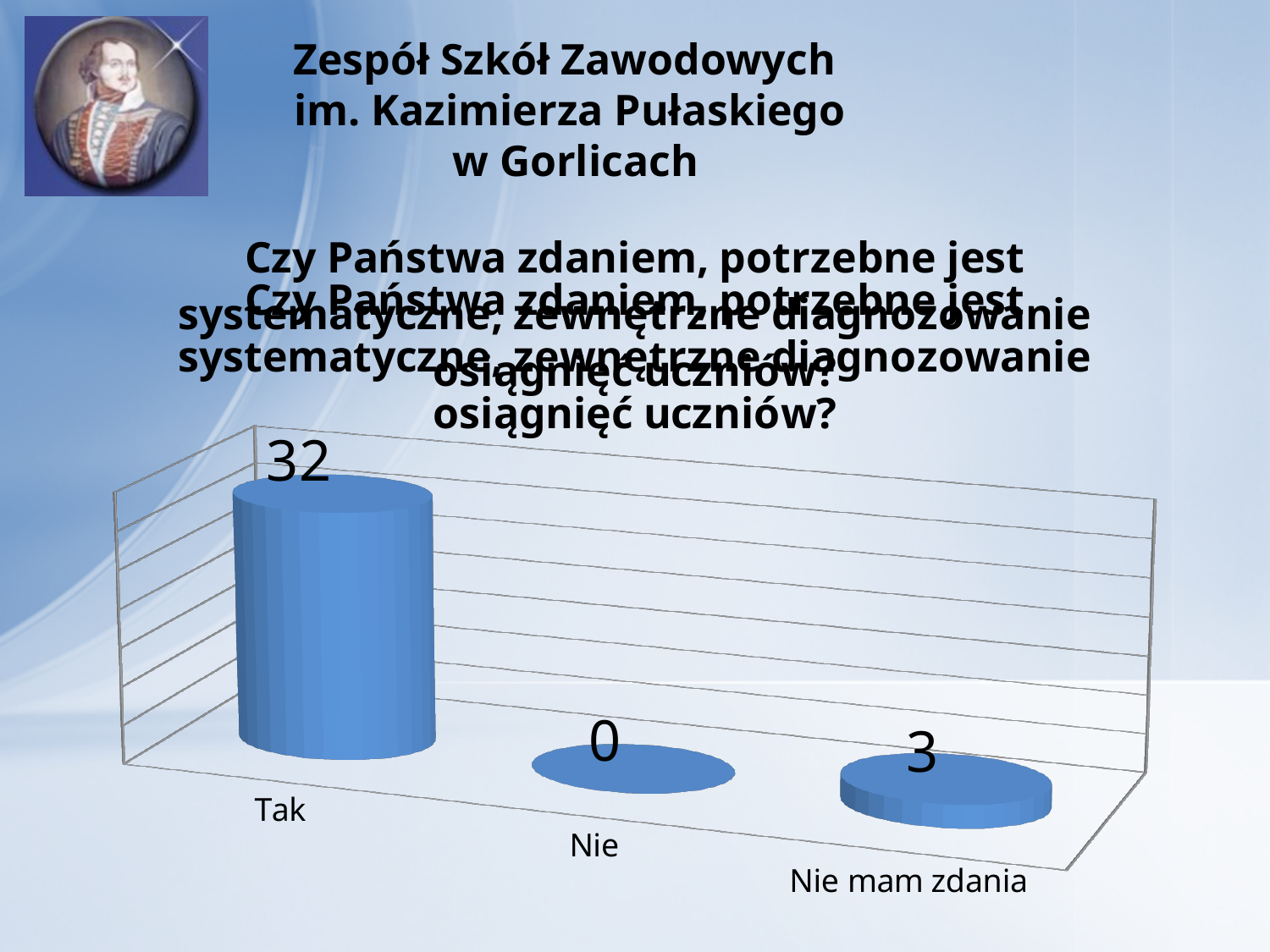
Which is larger, the value for Nie mam zdania or the value for Nie? Nie mam zdania What kind of chart is shown on the slide? bar chart Which category has the lowest value? Nie What is the value for Nie mam zdania? 3 What is the value for Tak? 32 What is the label of the third category on the x axis? Nie mam zdania Which category has the highest value? Tak How many categories are shown on the chart? 3 What is the difference between the values for Tak and Nie mam zdania? 29 What is the total of all three values shown on the chart? 35 What colour are the bars on the chart? blue What is the value for Nie? 0